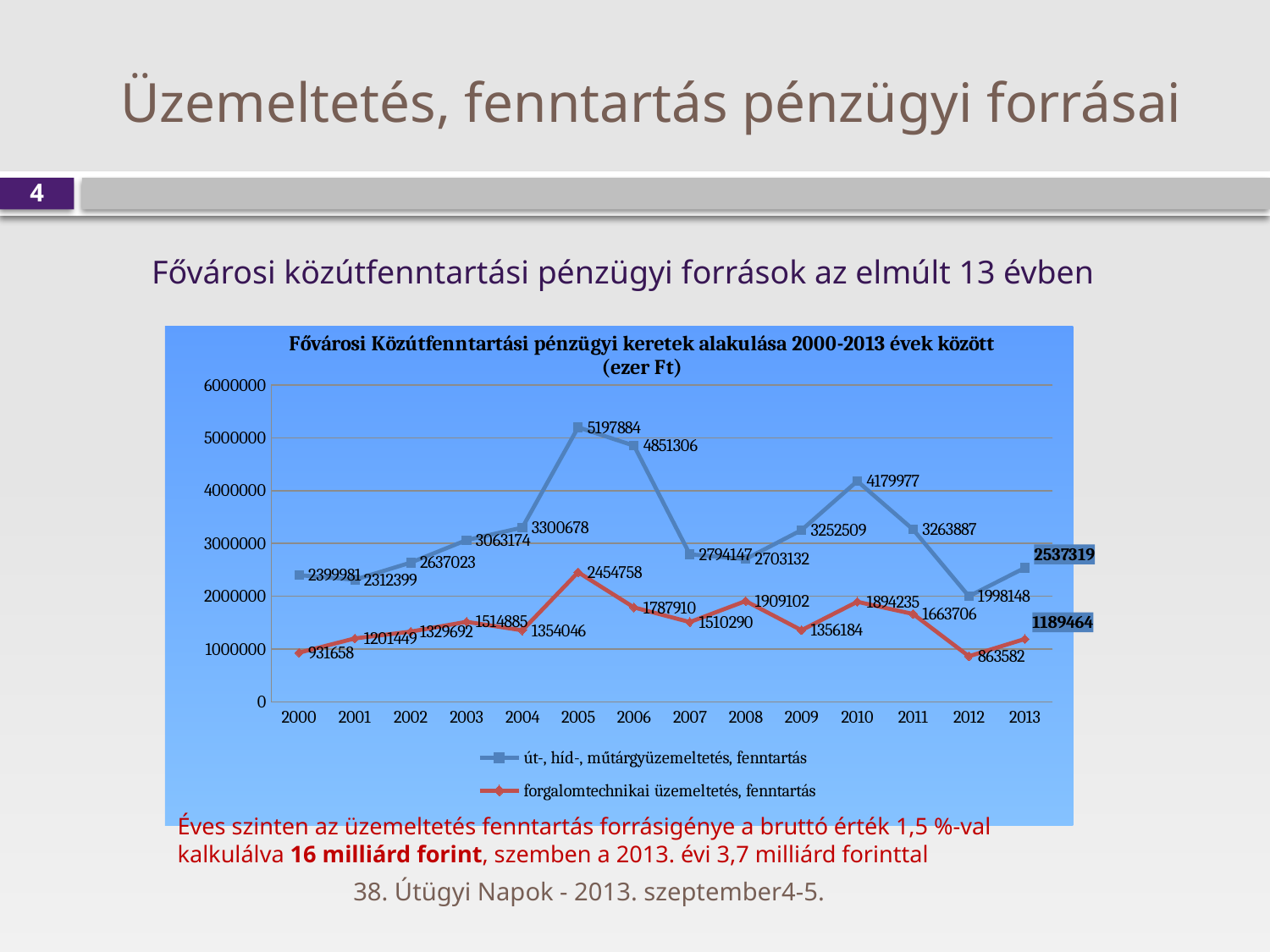
What is the value of the 'út-, híd-, műtárgyüzemeltetés, fenntartás' series in 2012? 1998148 How many series does the chart's legend list? 2 What kind of chart is shown on the slide? line chart Is the value of the 'forgalomtechnikai üzemeltetés, fenntartás' series in 2000 greater or less than 1000000? less In which year does the 'út-, híd-, műtárgyüzemeltetés, fenntartás' series reach its highest value? 2005 What is the difference between the two series' values in 2005? 2743126 What is the difference between the two series' values in 2013? 1347855 What is the value of the 'út-, híd-, műtárgyüzemeltetés, fenntartás' series in 2005? 5197884 Which series has the larger value in 2010? út-, híd-, műtárgyüzemeltetés, fenntartás What is the value of the 'forgalomtechnikai üzemeltetés, fenntartás' series in 2013? 1189464 How many years are shown on the x axis of the chart? 14 In which year is the 'forgalomtechnikai üzemeltetés, fenntartás' series at its lowest? 2012